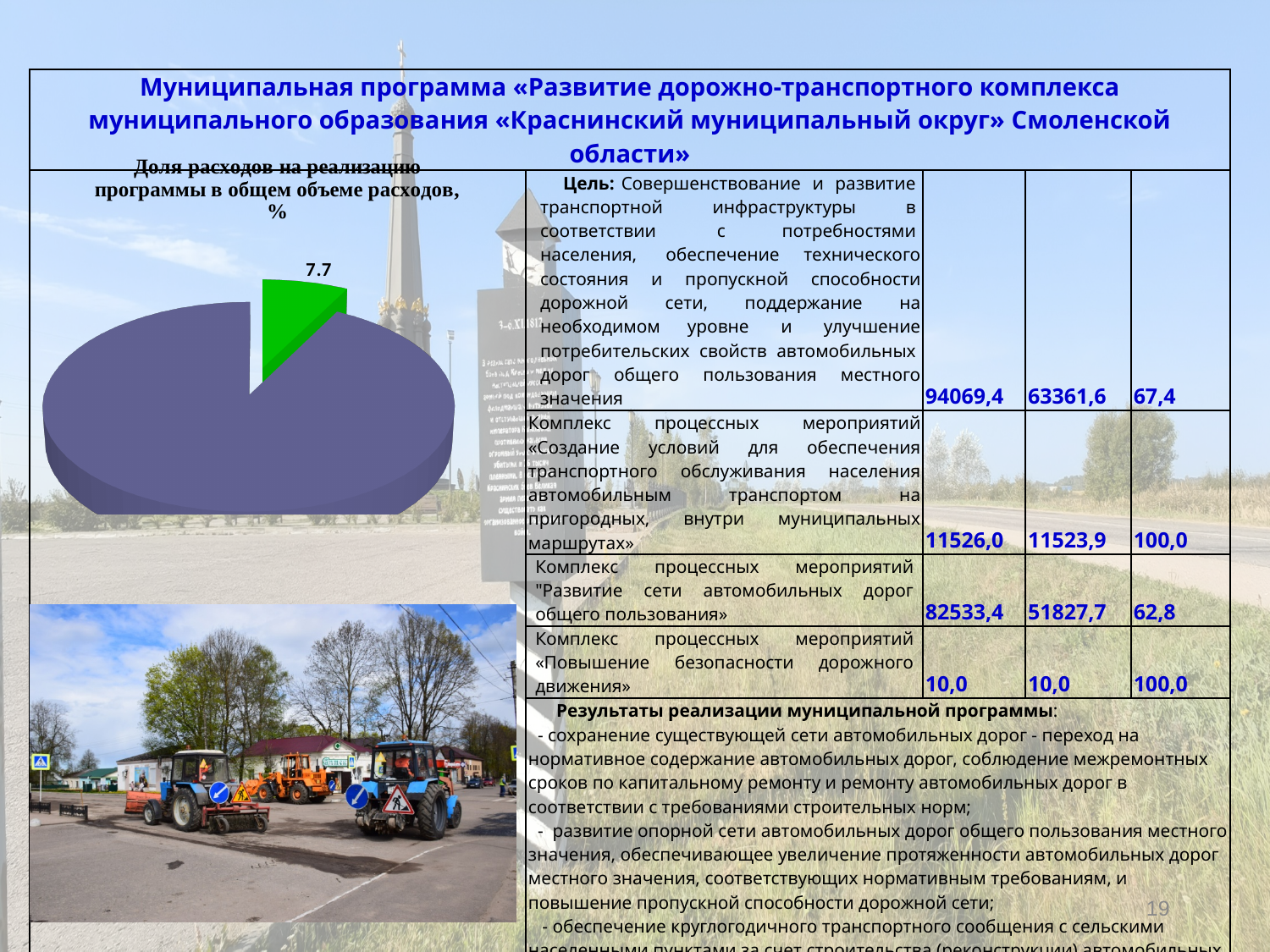
Which slice of the pie chart is larger, the green one or the purple one? the purple one How many slices does the pie chart have? 2 Which slice of the pie chart is the smallest? the green slice (7.7) What value is printed on the green slice of the pie chart? 7.7 What colour is the slice labelled 7.7 in the pie chart? green What is the title of the pie chart? Доля расходов на реализацию программы в общем объеме расходов, % What kind of chart is shown on the left of the slide? pie chart